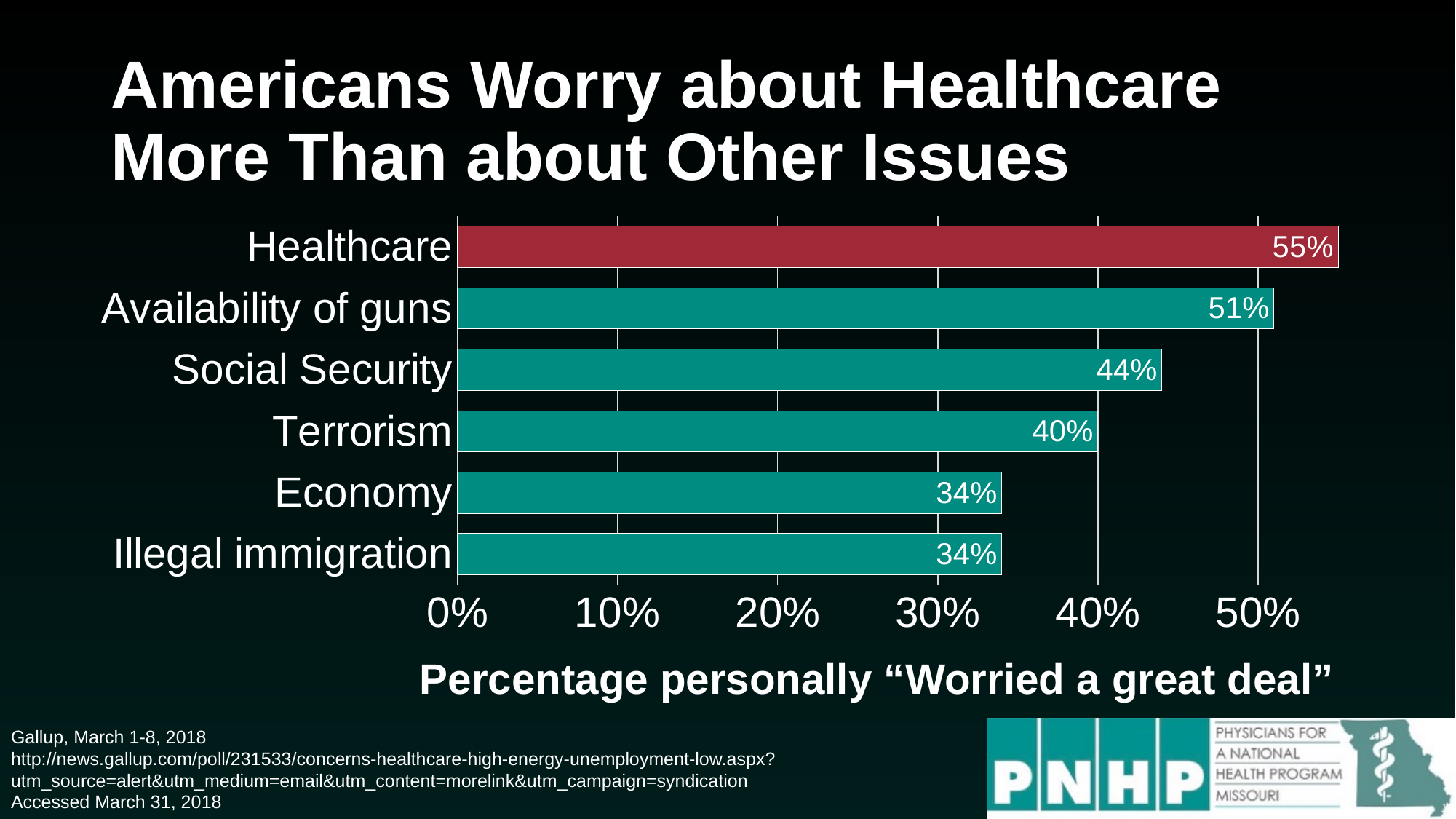
How many issues are shown in the chart? 6 What kind of chart is shown on the slide? Bar chart What is the value shown for Terrorism? 40% Is the value for Terrorism greater or less than 30%? greater What is the difference in percentage points between Healthcare and Availability of guns? 4 Which issue has the highest percentage of people worried a great deal? Healthcare Which is larger, the value for Social Security or the value for Terrorism? Social Security What is the value shown for Availability of guns? 51% What is the difference in percentage points between Social Security and Economy? 10 Which bar is shown in a different colour (red) from the others? Healthcare What percentage of Americans are worried a great deal about Healthcare? 55% Which two issues share the same value of 34%? Economy and Illegal immigration